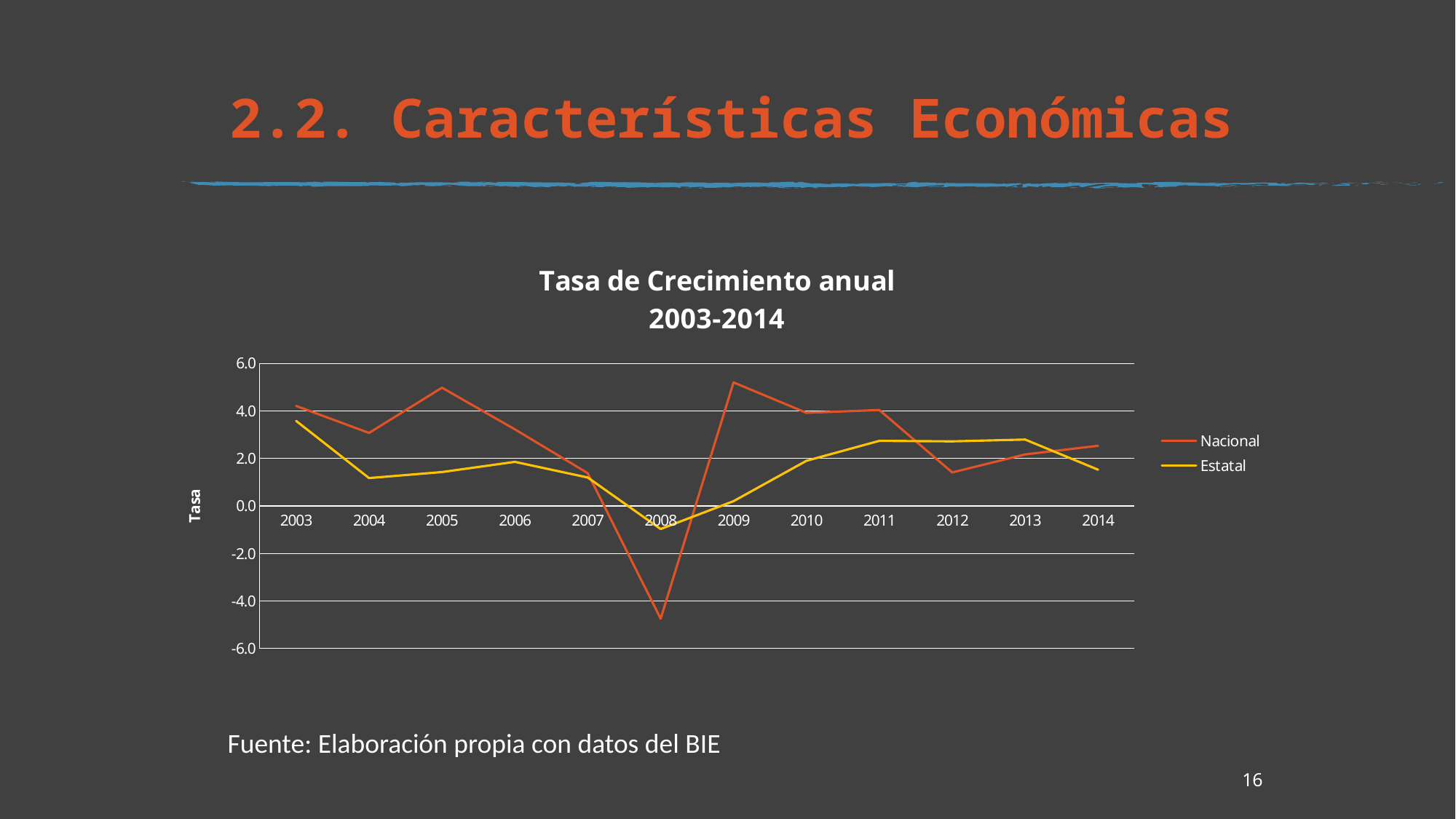
How many series does the legend list? 2 Which series has the larger value in 2009, Nacional or Estatal? Nacional In which year does the Estatal series reach its lowest value? 2008 Is the Estatal value for 2004 greater or less than 2.0? less What kind of chart is shown on the slide? Line chart How many years are plotted along the x axis? 12 Does the Nacional series rise or fall from 2009 to 2012? Fall In which year does the Estatal series reach its highest value? 2003 What is the title of the chart? Tasa de Crecimiento anual 2003-2014 Is the Nacional value for 2009 greater or less than 4.0? greater Is the Nacional value for 2008 greater or less than -4.0? less In which year does the Nacional series reach its lowest value? 2008